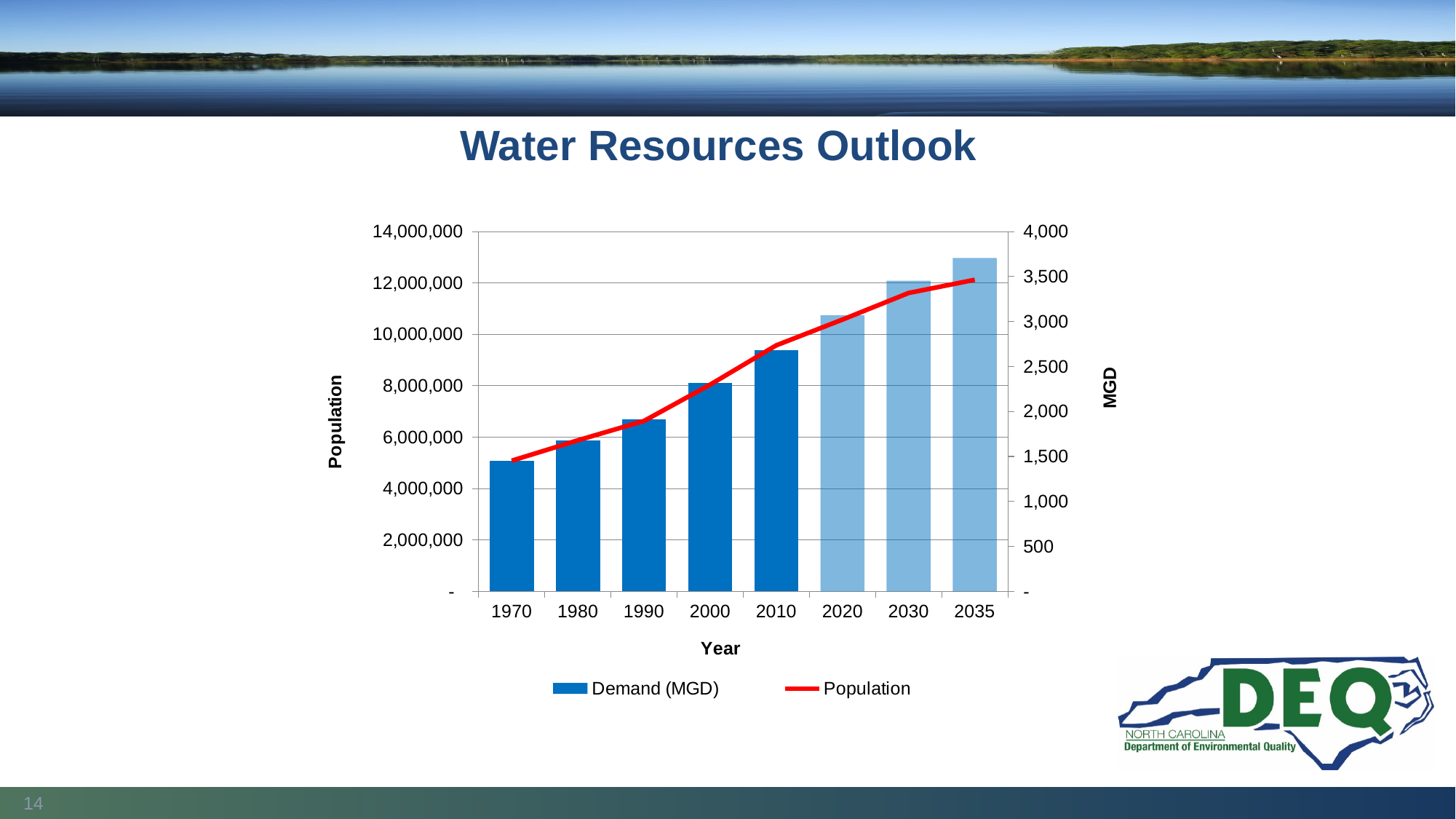
What kind of chart is shown on the slide? A bar chart combined with a line chart How many years are shown on the x axis? 8 Is the Demand (MGD) value for 1970 greater or less than 2,000? less Is the Population value for 2010 greater or less than 8,000,000? greater What is the title of the right-hand vertical axis? MGD Do the Demand (MGD) bars rise or fall from 1970 to 2035? Rise Is the Demand (MGD) value for 2035 greater or less than 3,500? greater Which year has the highest Demand (MGD) bar? 2035 Is the Demand (MGD) bar for 2000 larger or smaller than the bar for 2010? smaller How many series does the legend list? 2 Which year has the lowest Demand (MGD) bar? 1970